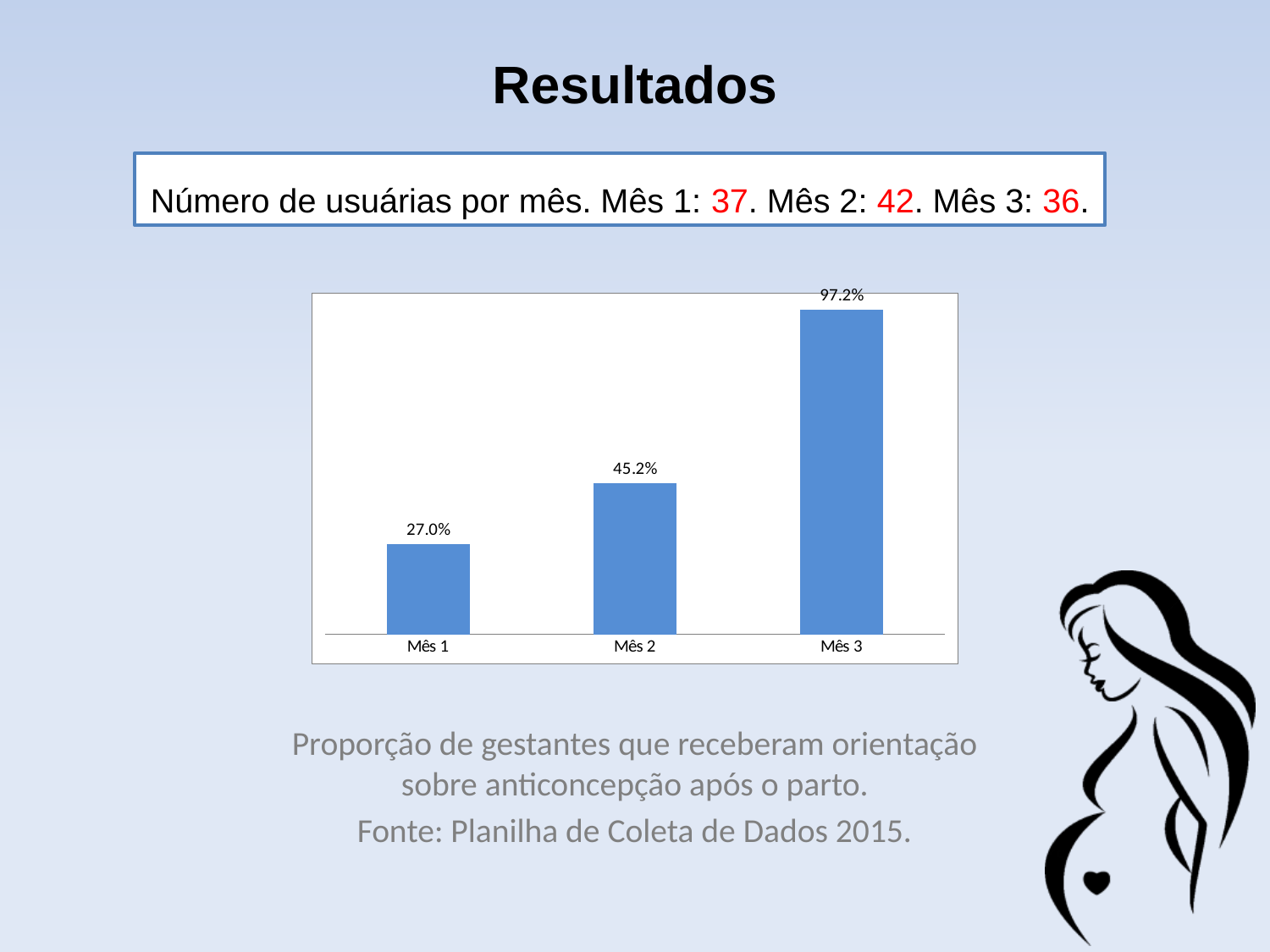
According to the caption below the chart, what is the source of the data? Planilha de Coleta de Dados 2015 What is the difference between the values for Mês 2 and Mês 1? 18.2% What is the value for Mês 2? 45.2% Which month has the highest value? Mês 3 What kind of chart is shown on the slide? Bar chart Do the values rise or fall from Mês 1 to Mês 3? Rise Which month has the lowest value? Mês 1 How many categories are shown on the x axis? 3 What is the value for Mês 1? 27.0% What is the difference between the values for Mês 3 and Mês 2? 52.0% Which is larger, the value for Mês 1 or the value for Mês 2? Mês 2 What is the value for Mês 3? 97.2%